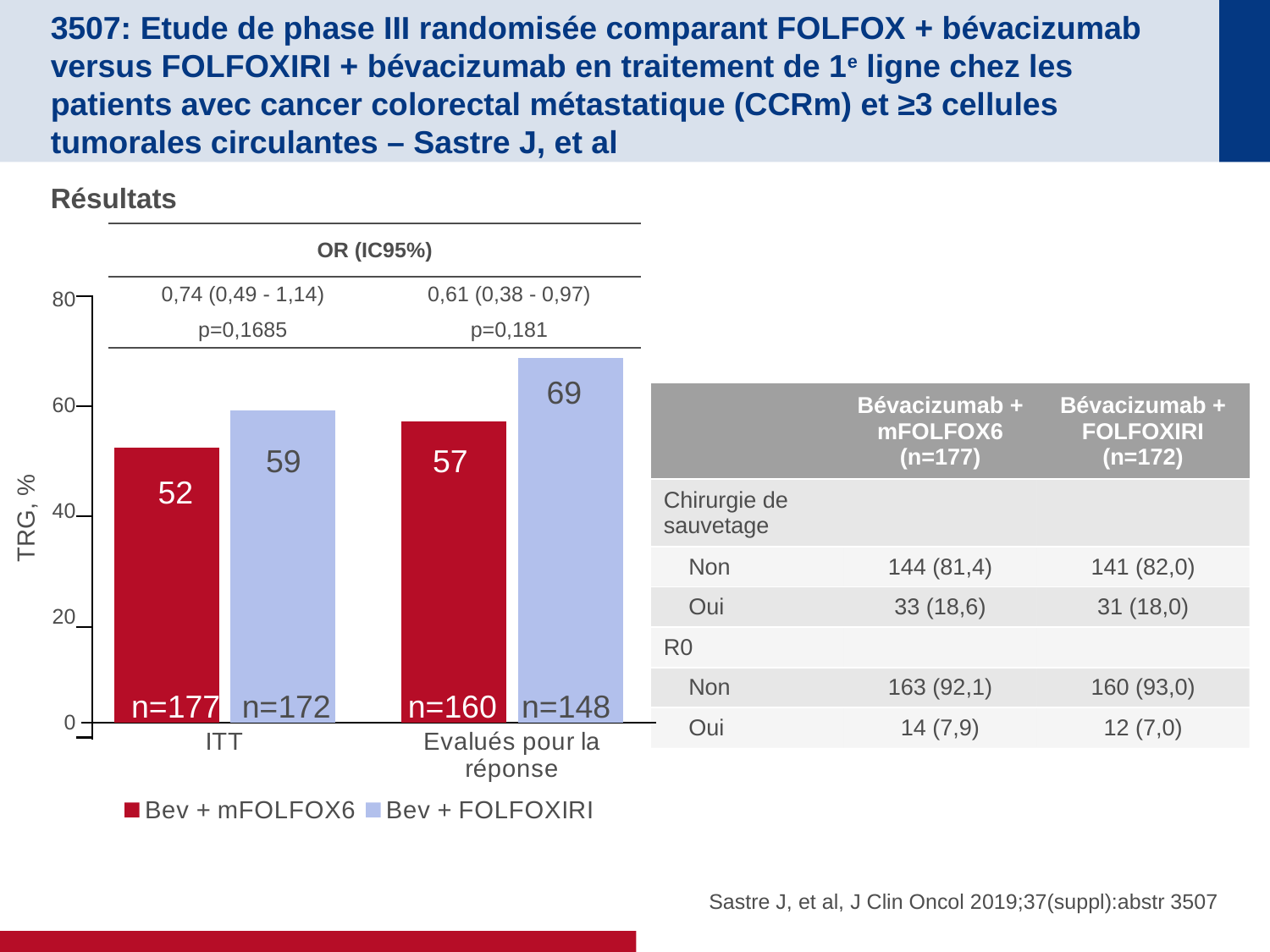
Which bar has the lowest TRG value on the chart? Bev + mFOLFOX6, ITT What is the difference in TRG between Bev + FOLFOXIRI and Bev + mFOLFOX6 among patients evaluated for response? 12 What is the TRG value for Bev + mFOLFOX6 among patients evaluated for response (Evalués pour la réponse)? 57 In the ITT group, which series has the larger TRG: Bev + mFOLFOX6 or Bev + FOLFOXIRI? Bev + FOLFOXIRI What is the TRG value for Bev + FOLFOXIRI in the ITT group? 59 What is the TRG value for Bev + FOLFOXIRI among patients evaluated for response (Evalués pour la réponse)? 69 How many series does the chart legend list? 2 What is the difference in TRG between Bev + FOLFOXIRI and Bev + mFOLFOX6 in the ITT group? 7 What is the label of the y axis of the chart? TRG, % What type of chart is shown on the slide? Bar chart What is the TRG value for Bev + mFOLFOX6 in the ITT group? 52 Which bar has the highest TRG value on the chart? Bev + FOLFOXIRI, Evalués pour la réponse